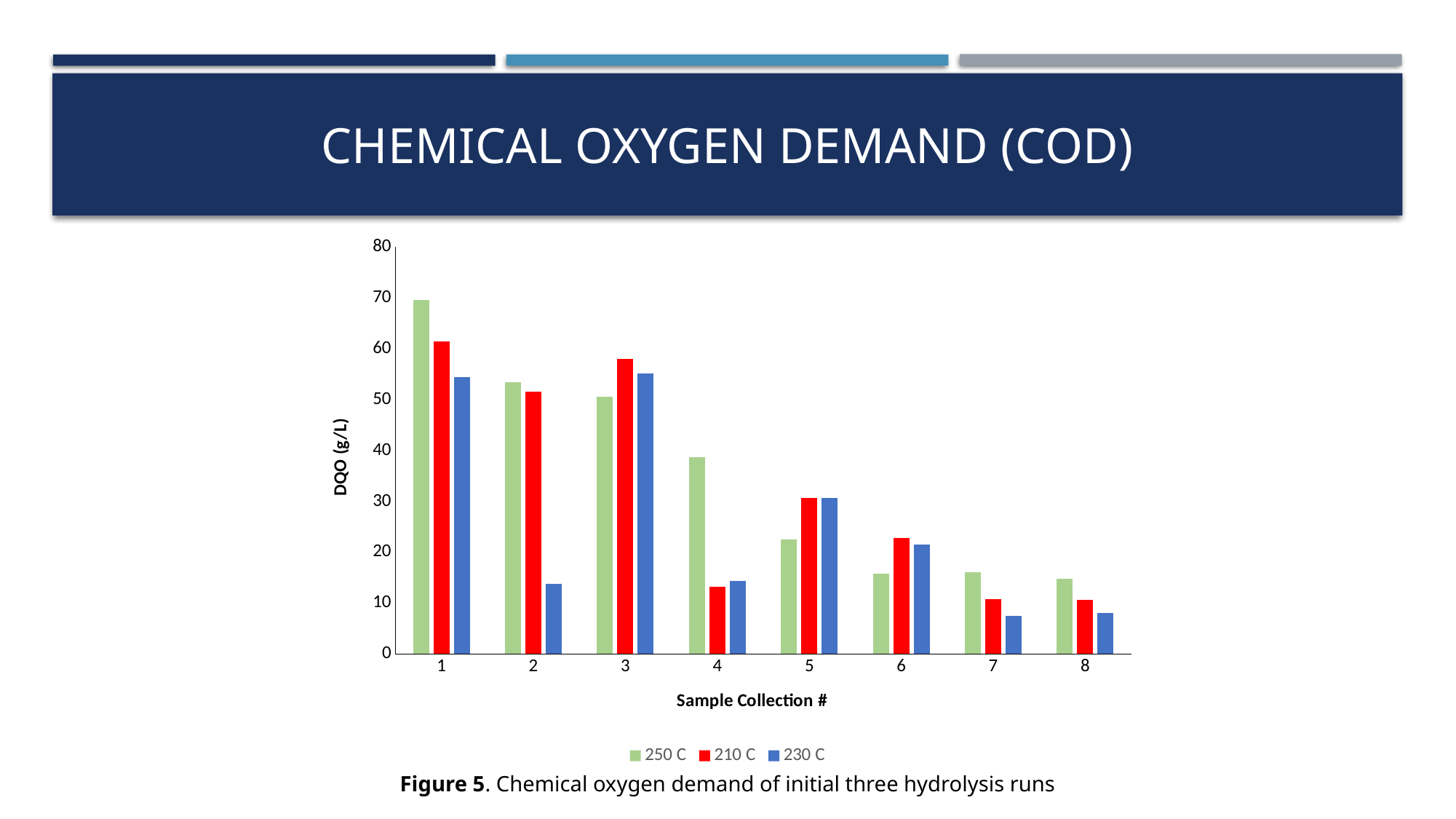
What kind of chart is shown on the slide? bar chart At sample collection 1, which series has the highest value? 250 C Is the value for 250 C at sample collection 4 greater or less than 30? greater Is the value for 230 C at sample collection 2 greater or less than 20? less What is the label of the y axis? DQO (g/L) How many sample collections are shown on the x axis? 8 Is the value for 250 C at sample collection 1 greater or less than 60? greater At sample collection 3, which is larger: the 210 C value or the 250 C value? 210 C Which sample collection has the highest value for the 250 C series? 1 Do the 250 C values generally rise or fall from sample collection 1 to sample collection 8? fall How many series does the legend list? 3 At sample collection 2, which is larger: the 250 C value or the 230 C value? 250 C